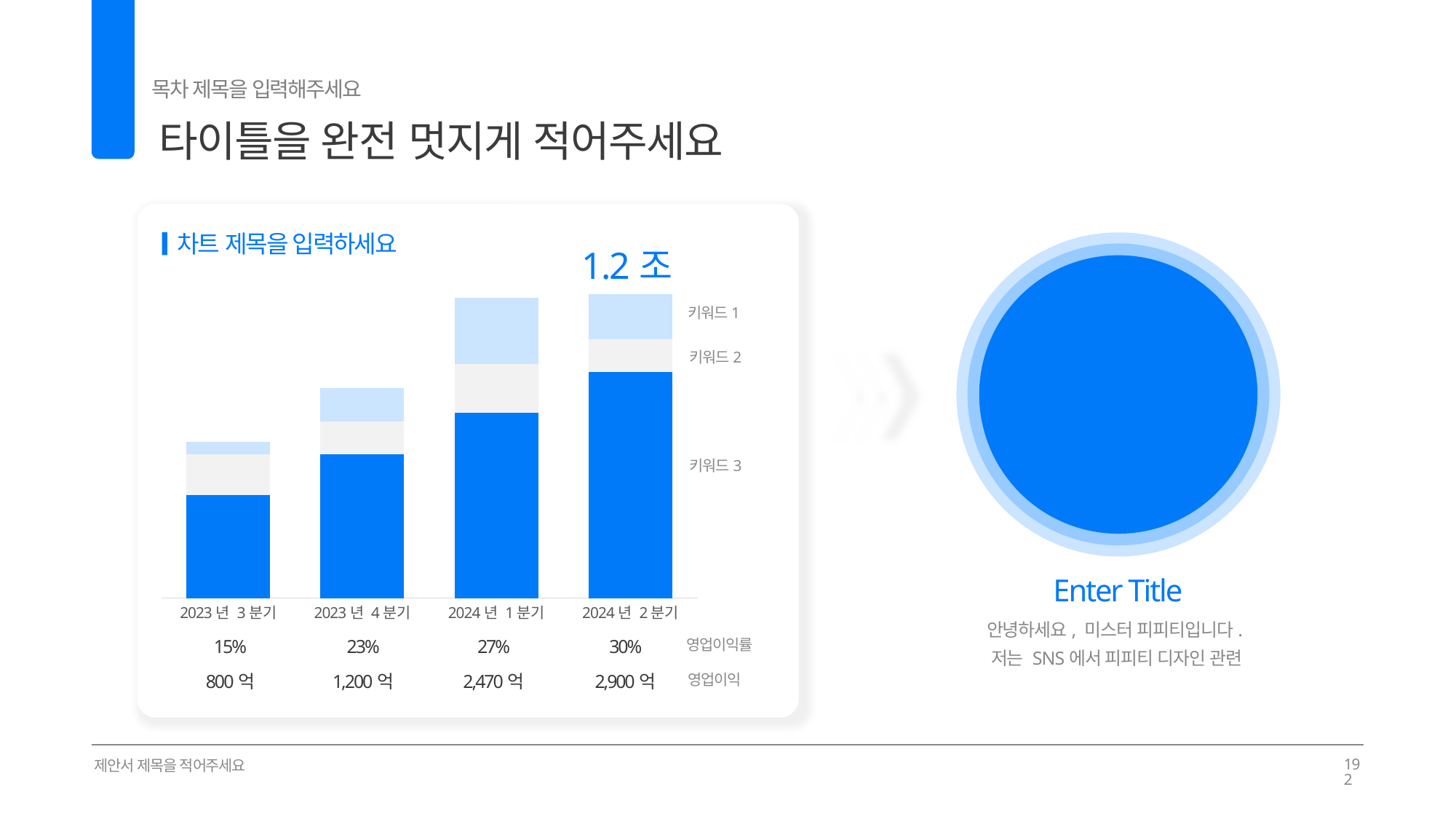
Which quarter has the tallest stacked bar? 2024 년 2 분기 What is the 영업이익 value shown for 2024 년 1 분기? 2,470 억 How many series (키워드 labels) does the chart show? 3 Which quarter has the larger 영업이익, 2023 년 4 분기 or 2024 년 1 분기? 2024 년 1 분기 How many quarters (categories) are shown on the x axis of the chart? 4 What value label is printed above the bar for 2024 년 2 분기? 1.2 조 What is the difference in 영업이익 between 2024 년 2 분기 and 2023 년 3 분기? 2,100 억 What kind of chart is shown on the slide? stacked bar chart Which quarter has the shortest stacked bar? 2023 년 3 분기 What is the 영업이익률 value shown for 2023 년 4 분기? 23% What is the difference between the 영업이익률 for 2024 년 2 분기 and 2023 년 3 분기? 15 percentage points Do the stacked bar totals rise or fall from 2023 년 3 분기 to 2024 년 2 분기? rise